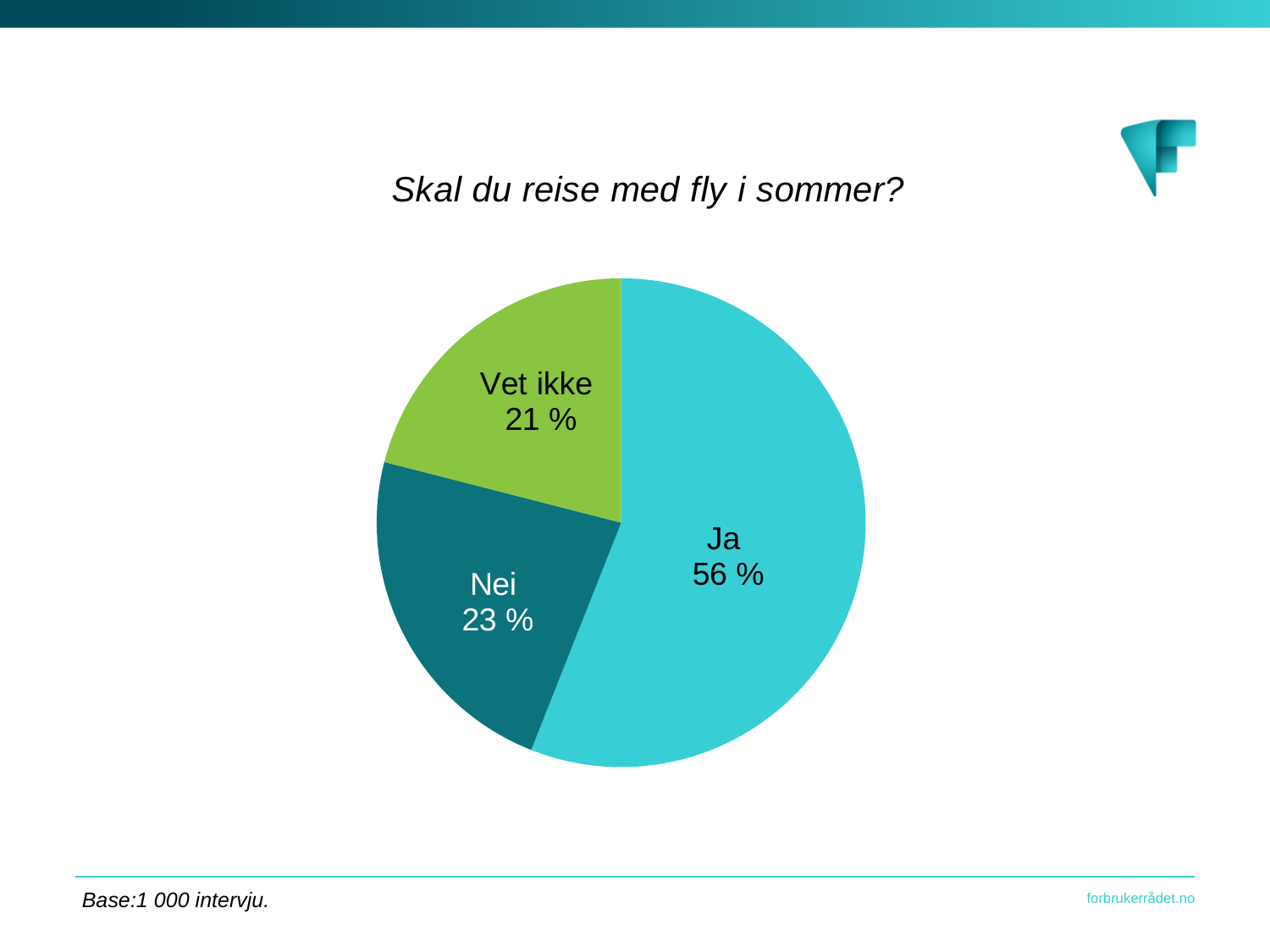
What is the title of the chart? Skal du reise med fly i sommer? How many slices does the pie chart have? 3 Which slice of the pie is the smallest? Vet ikke What share of the pie is labelled "Ja"? 56 % What share of the pie is labelled "Vet ikke"? 21 % What kind of chart is shown on the slide? pie chart Which slice of the pie is the largest? Ja What is the difference in percentage points between the "Ja" and "Nei" slices? 33 Which is larger, the "Ja" slice or the "Nei" slice? Ja What share of the pie is labelled "Nei"? 23 % What is the difference in percentage points between the "Nei" and "Vet ikke" slices? 2 What colour is the "Vet ikke" slice? green